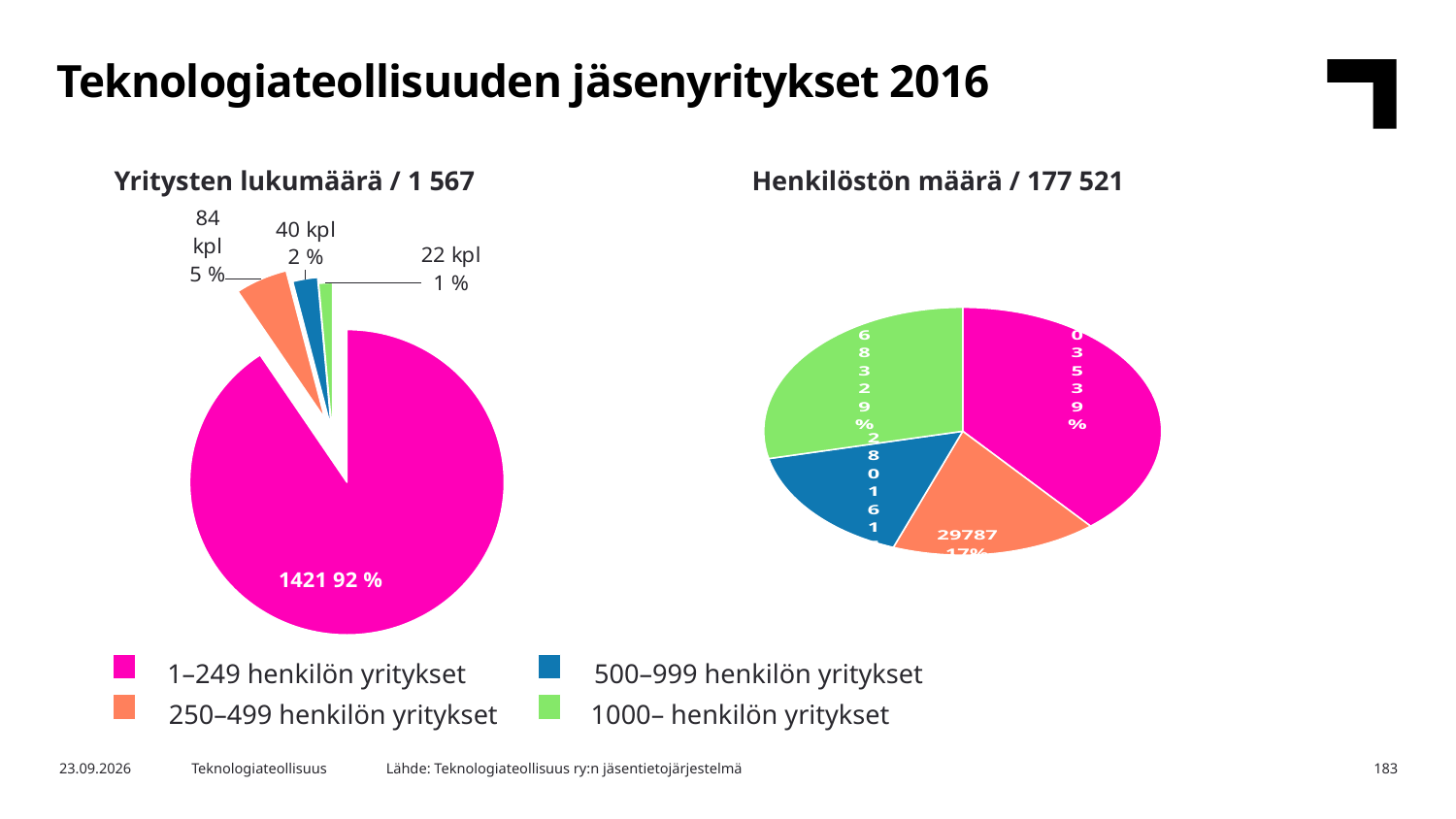
Which colour represents 1000– henkilön yritykset in the charts? green How many categories does the legend list? 4 In the 'Yritysten lukumäärä / 1 567' chart, what share of the pie do 500–999 henkilön yritykset have? 2 % In the 'Yritysten lukumäärä / 1 567' chart, which category has the smallest slice? 1000– henkilön yritykset In the 'Yritysten lukumäärä / 1 567' chart, what share of the pie do 1–249 henkilön yritykset have? 92 % What kind of chart is used for 'Yritysten lukumäärä / 1 567'? pie chart In the 'Henkilöstön määrä / 177 521' chart, what is the value for 250–499 henkilön yritykset? 29787 In the 'Yritysten lukumäärä / 1 567' chart, how many companies are in the 1–249 henkilön yritykset category? 1421 In the 'Yritysten lukumäärä / 1 567' chart, which category has the largest slice? 1–249 henkilön yritykset In the 'Yritysten lukumäärä / 1 567' chart, what is the difference in company count between the 250–499 and 500–999 categories? 44 In the 'Yritysten lukumäärä / 1 567' chart, how many companies are in the 1000– henkilön yritykset category? 22 kpl In the 'Yritysten lukumäärä / 1 567' chart, how many companies are in the 250–499 henkilön yritykset category? 84 kpl